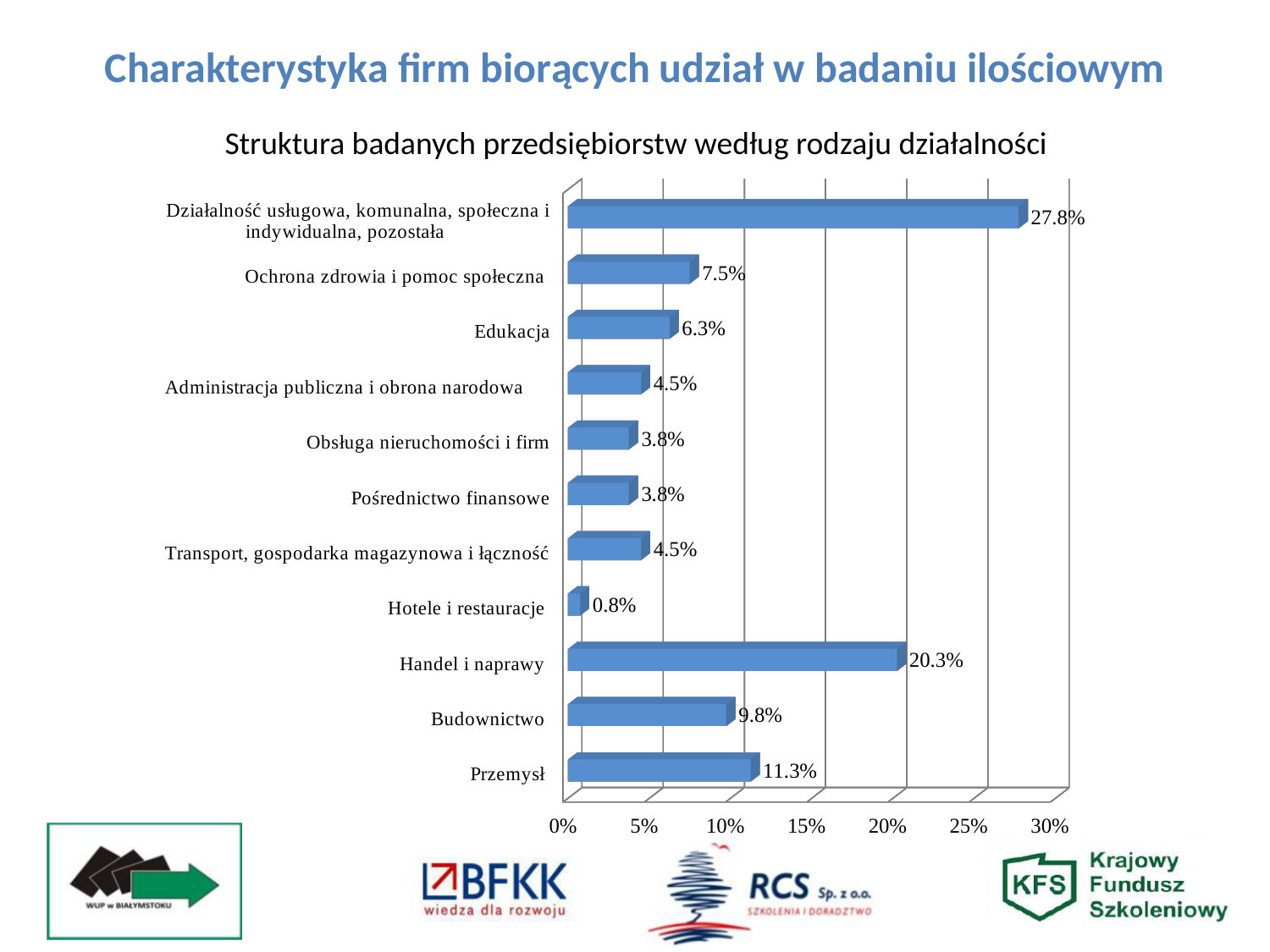
Which category has the lowest value? Hotele i restauracje What is the value for Budownictwo? 9.8% What is the difference between the values for Przemysł and Budownictwo? 1.5% Which is larger, the value for Ochrona zdrowia i pomoc społeczna or the value for Edukacja? Ochrona zdrowia i pomoc społeczna What is the value for Handel i naprawy? 20.3% What is the value for Edukacja? 6.3% Is the value for Handel i naprawy greater or less than 20%? greater What kind of chart is shown on the slide? bar chart What is the title of the chart? Struktura badanych przedsiębiorstw według rodzaju działalności How many categories are shown in the chart? 11 Which category has the highest value? Działalność usługowa, komunalna, społeczna i indywidualna, pozostała What is the difference between the values for Działalność usługowa, komunalna, społeczna i indywidualna, pozostała and Handel i naprawy? 7.5%